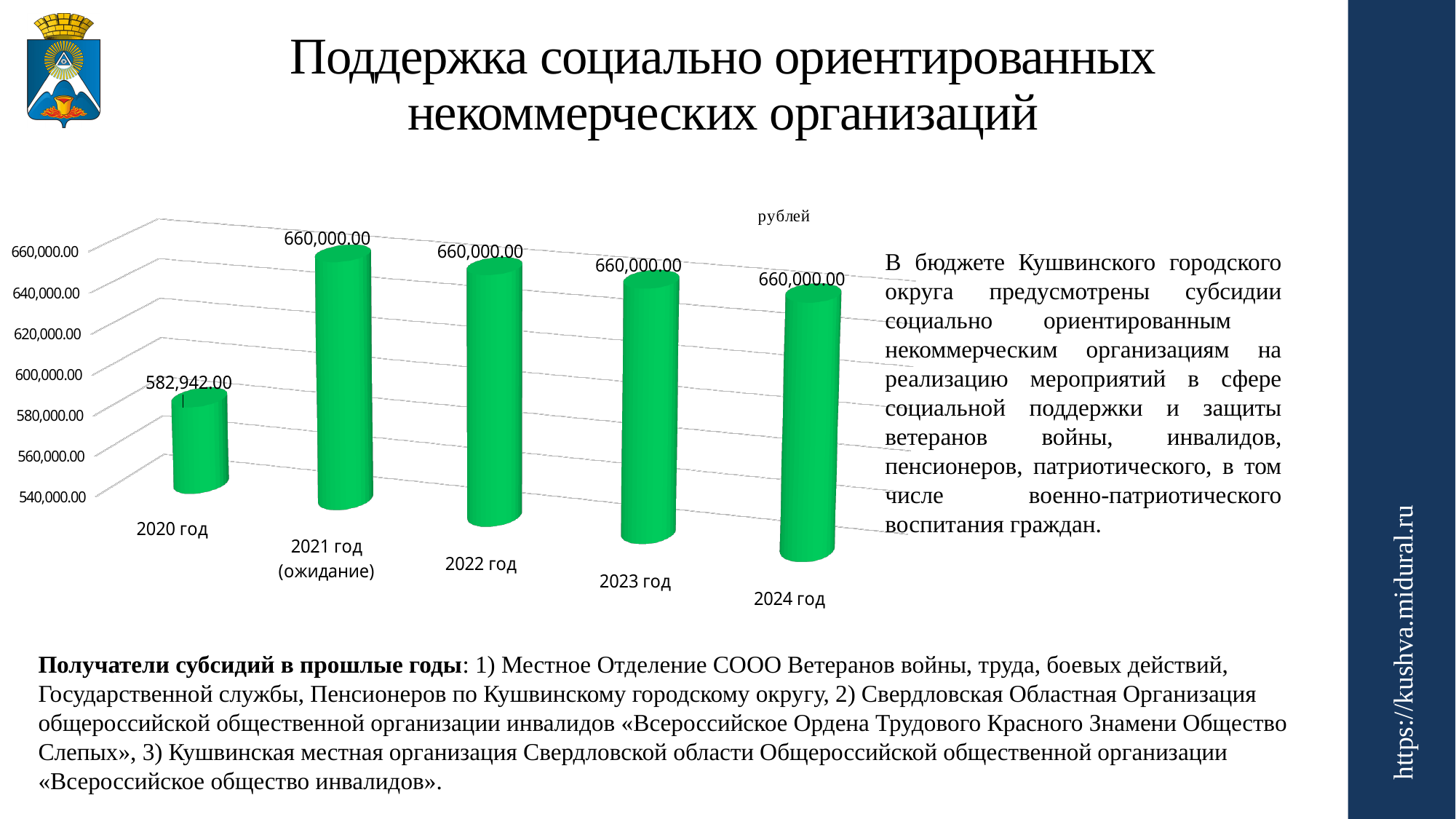
What is the value for 2020 год? 582,942.00 Which is larger, the value for 2020 год or the value for 2022 год? 2022 год What is the difference between the values for 2021 год (ожидание) and 2020 год? 77,058.00 Is the value for 2020 год greater or less than 600,000.00? less What is the value for 2024 год? 660,000.00 Does the value rise or fall from 2020 год to 2021 год (ожидание)? rise Which year has the lowest value? 2020 год What kind of chart is shown on the slide? bar chart What unit label is shown above the chart? рублей How many years are shown on the chart? 5 Is the value for 2023 год greater or less than 640,000.00? greater What is the value for 2021 год (ожидание)? 660,000.00